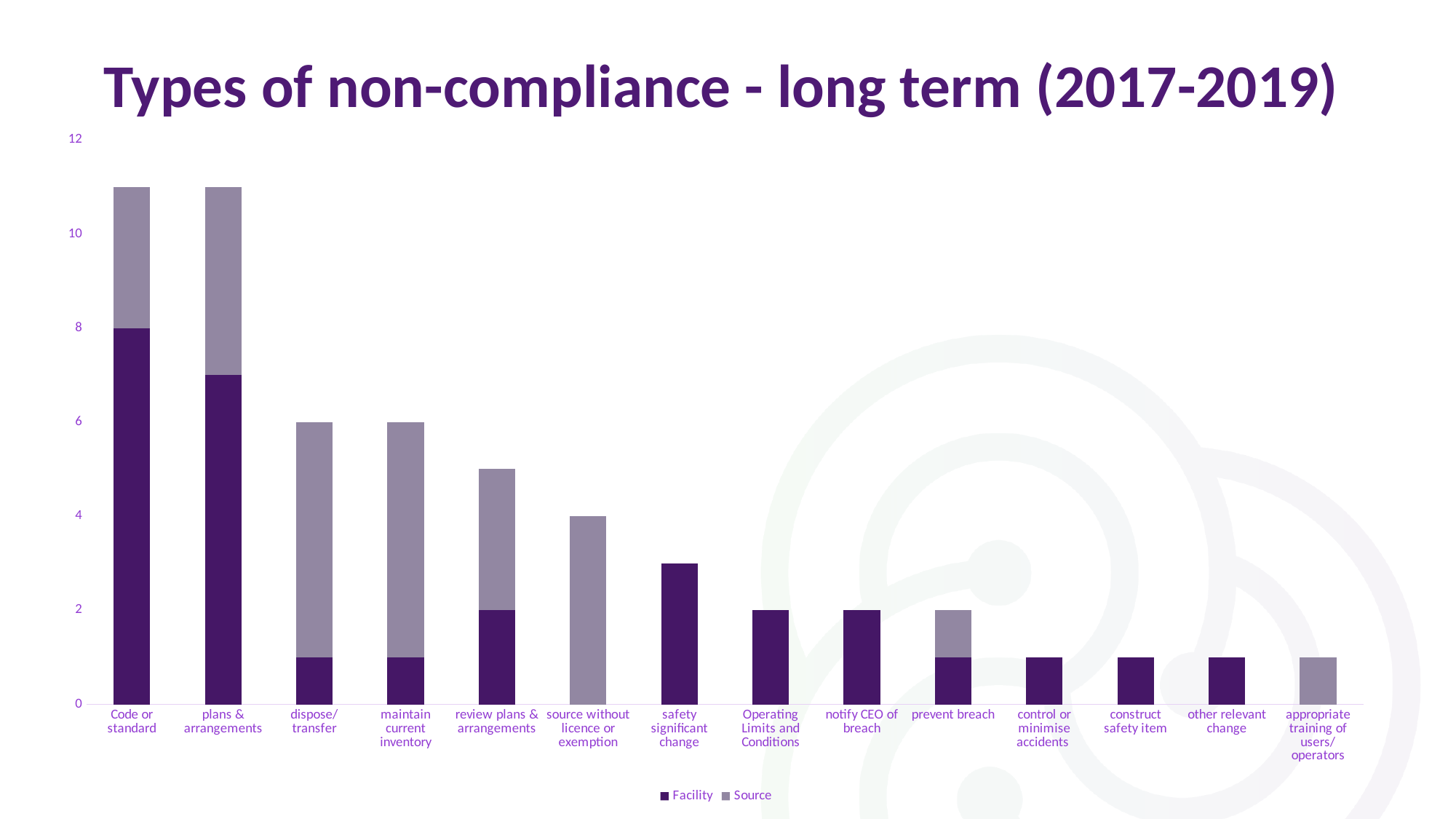
How many non-compliance categories are shown along the x axis? 14 How many series does the legend list? 2 What is the Facility value for 'Operating Limits and Conditions'? 2 What is the Facility value for 'Code or standard'? 8 Which has a larger total, 'Code or standard' or 'dispose/ transfer'? Code or standard Do the total bar heights generally rise or fall from left to right along the x axis? fall Is the value for 'safety significant change' greater or less than 2? greater What is the Source value for 'source without licence or exemption'? 4 Is the Facility value for 'plans & arrangements' greater or less than 8? less What kind of chart is shown on the slide? Stacked bar chart Is the total value for 'Code or standard' greater or less than 10? greater What is the total height of the 'dispose/ transfer' bar? 6